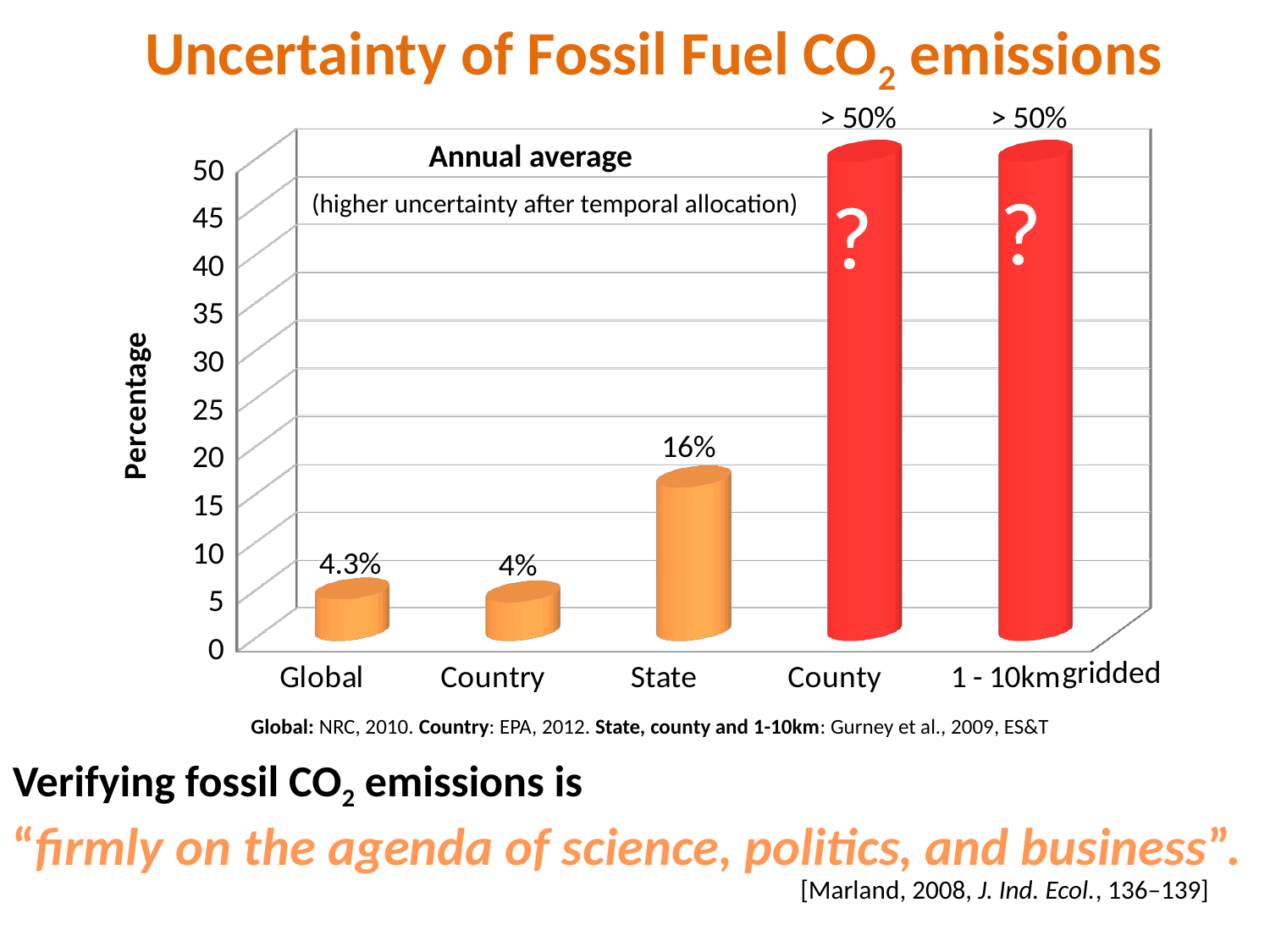
What is the value for Country? 4% How many categories are shown on the x axis? 5 What is the value for Global? 4.3% What is the difference between the values for State and Global? 11.7% What is the value for State? 16% What is the label on the y axis? Percentage Do the values generally rise or fall from Global to 1 - 10km gridded? rise What kind of chart is this? Bar chart Which is larger, the value for Global or the value for Country? Global What label is shown above the County bar? > 50% Is the value for County greater or less than 40? greater What is the difference between the values for State and Country? 12%